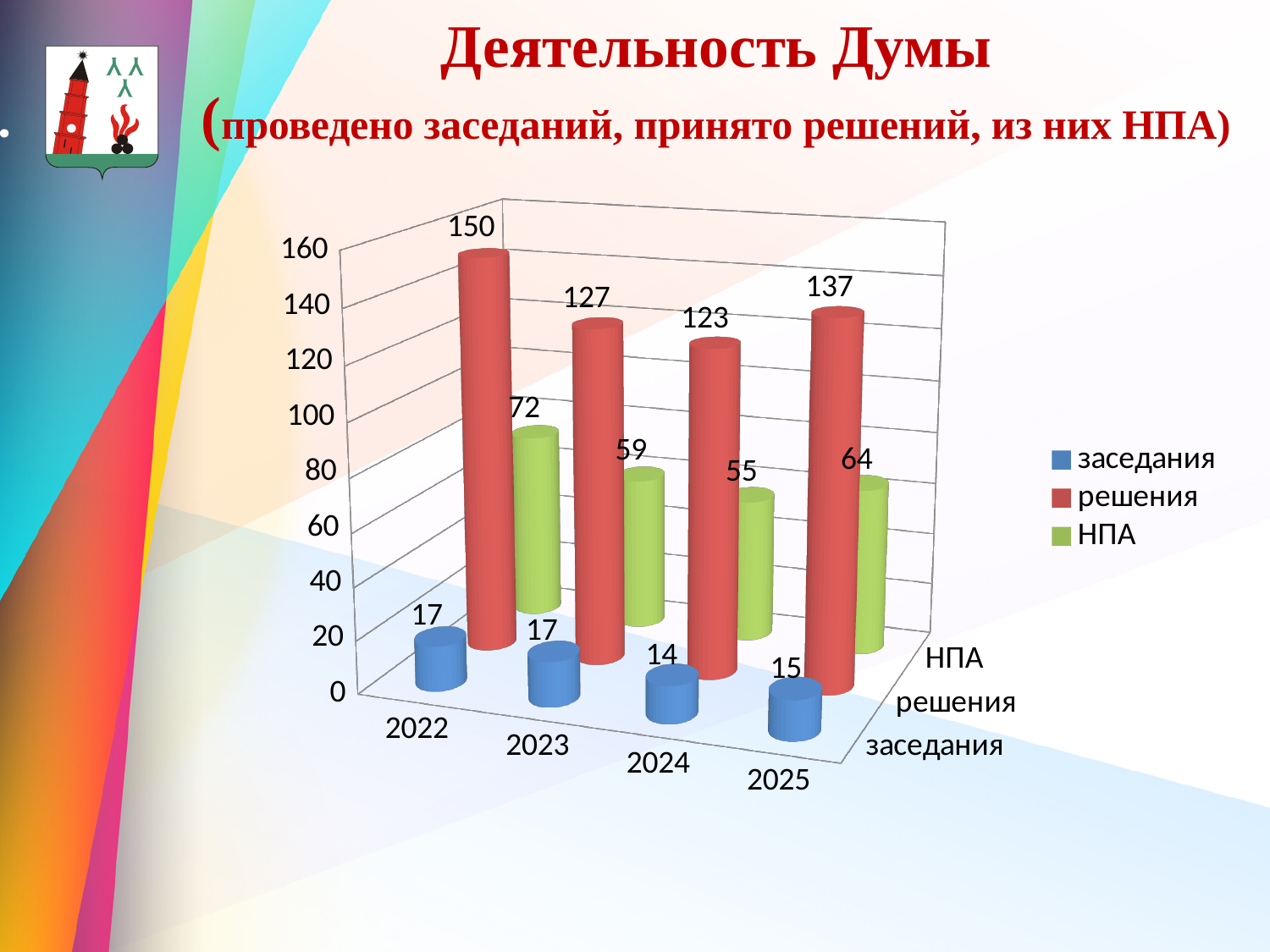
What is the difference between the НПА values for 2022 and 2025? 8 In which year is the value for НПА the lowest? 2024 Which is larger: the решения value for 2023 or for 2025? 2025 How many years are shown on the x axis of the chart? 4 What kind of chart is shown on the slide? bar chart What is the value for заседания in 2025? 15 In which year is the value for решения the highest? 2022 What is the value for НПА in 2024? 55 What is the difference between the решения values for 2022 and 2024? 27 Which series is shown in green in the legend? НПА What is the value for решения in 2022? 150 How many series does the legend list? 3